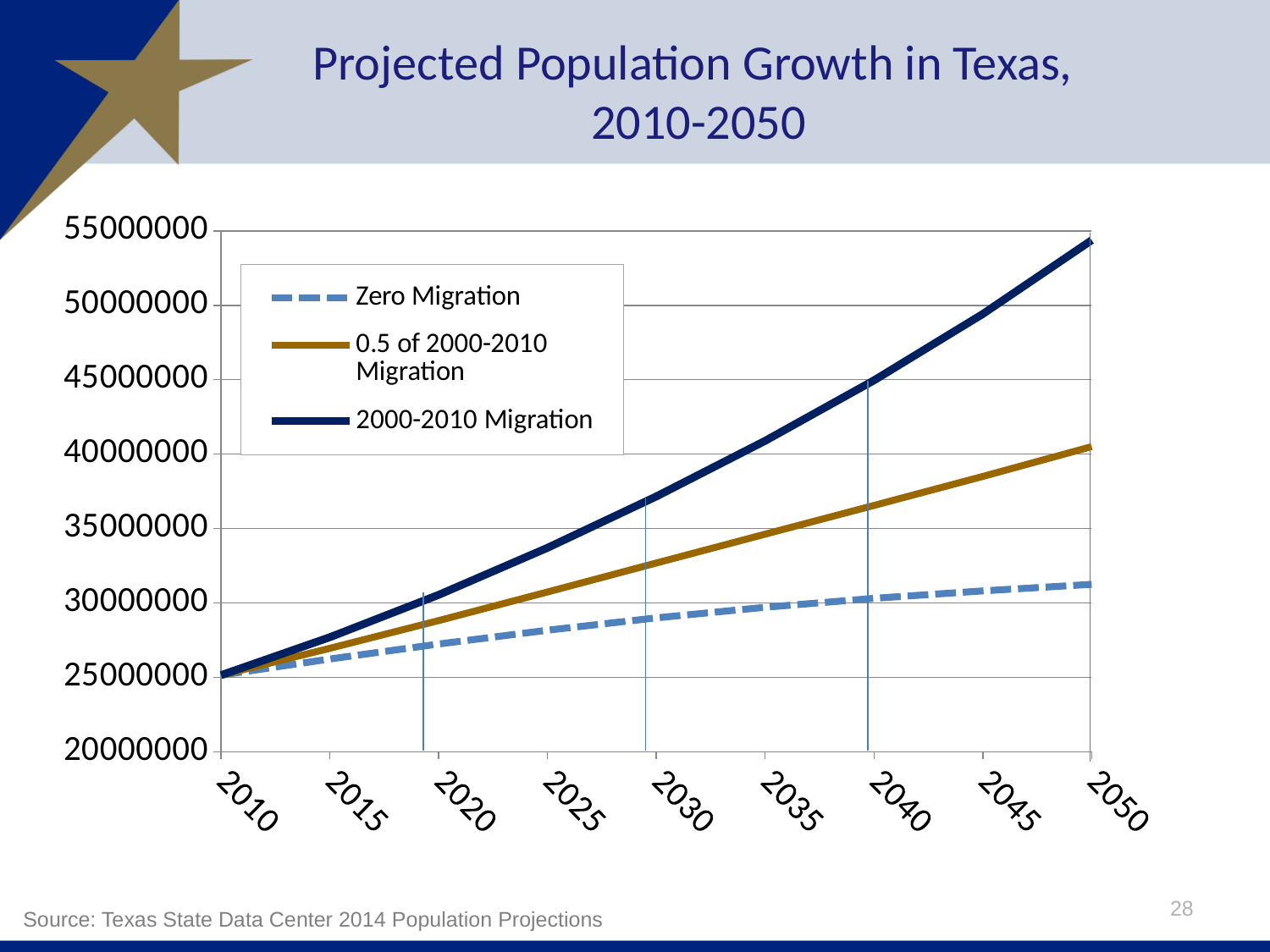
Which series has the lowest value in 2050? Zero Migration Do the values for the Zero Migration series rise or fall from 2010 to 2050? rise How many year labels are shown along the x axis? 9 Is the value for 2000-2010 Migration in 2050 greater or less than 50000000? greater Which series has the highest value in 2050? 2000-2010 Migration How many series does the legend list? 3 Is the value for Zero Migration in 2030 greater or less than 30000000? less Which series is drawn with a dashed line? Zero Migration What kind of chart is shown on the slide? line chart Is the value for 0.5 of 2000-2010 Migration in 2040 greater or less than 35000000? greater In 2040, which is larger: the value for 2000-2010 Migration or the value for Zero Migration? 2000-2010 Migration